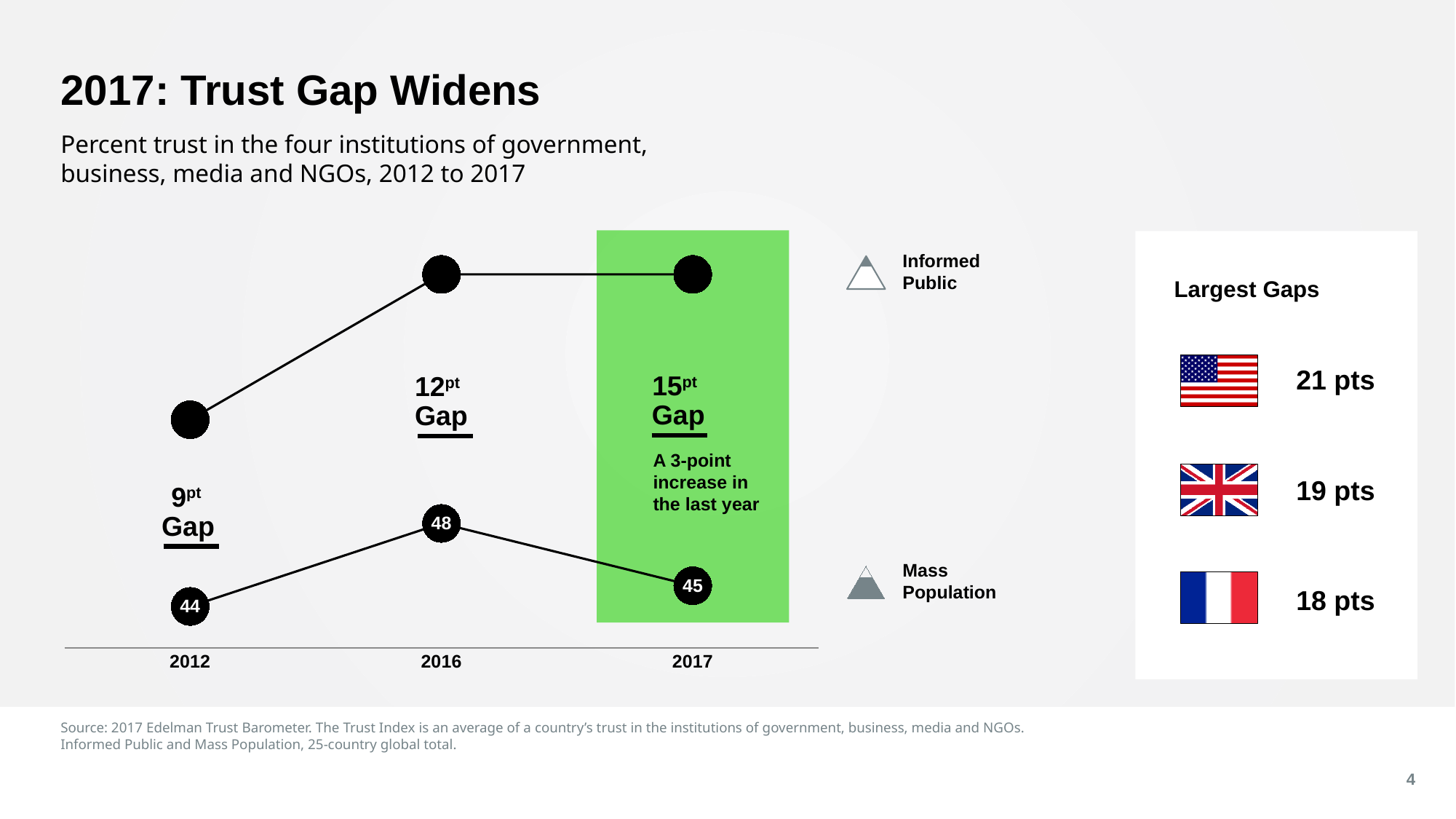
What is the difference between the Mass Population values in 2016 and 2012? 4 By how many points did the Mass Population trust value fall from 2016 to 2017? 3 What kind of chart is shown on the slide? line chart How many years are plotted on the x axis of the chart? 3 Does the Informed Public line rise or fall from 2012 to 2016? rise In which year is the Mass Population trust value lowest? 2012 What is the Mass Population trust value in 2012? 44 What is the Mass Population trust value in 2016? 48 What is the Mass Population trust value in 2017? 45 Which year has the larger Mass Population trust value, 2012 or 2017? 2017 How many series does the chart legend list? 2 In which year is the Mass Population trust value highest? 2016